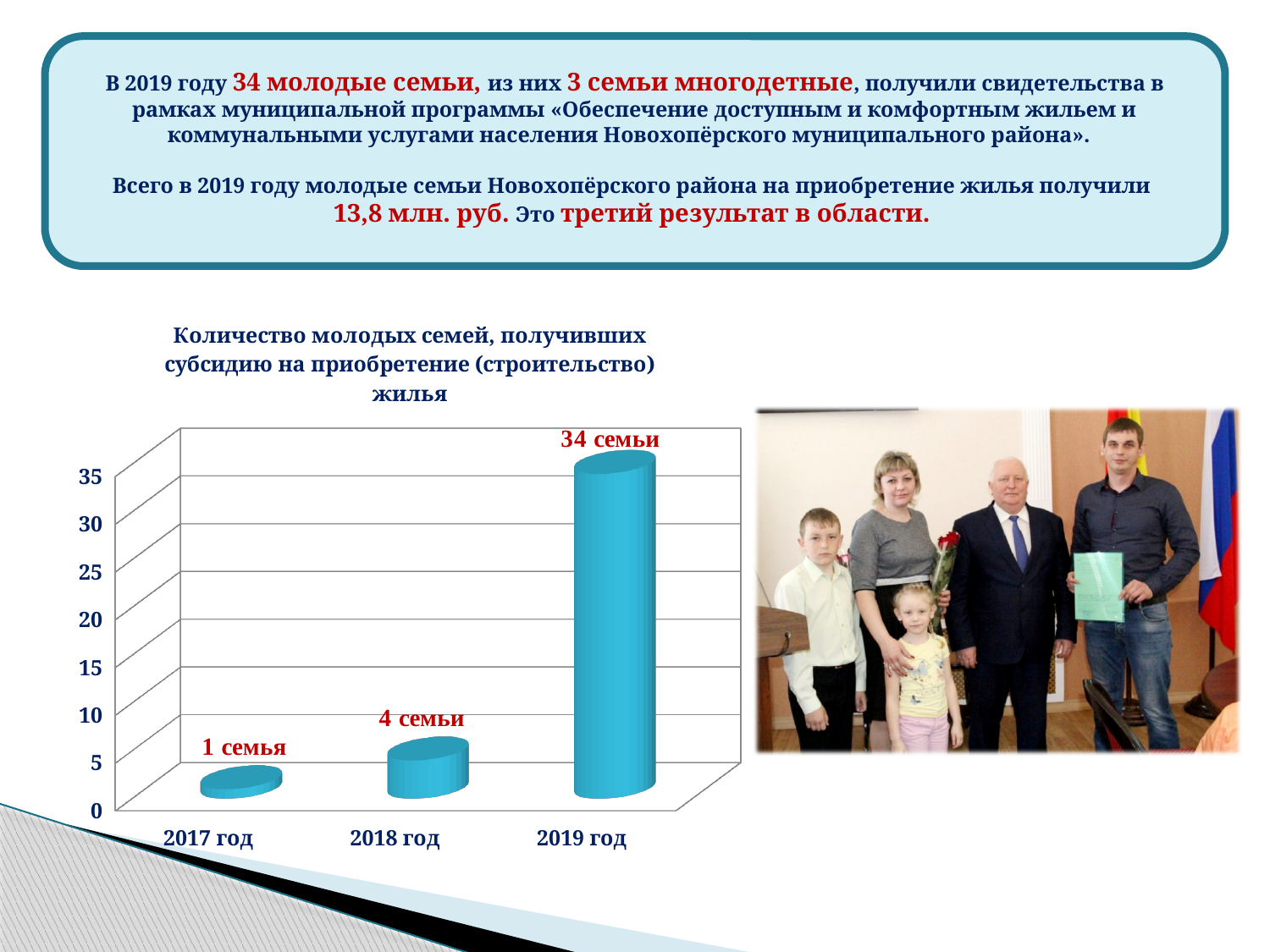
What kind of chart is shown on the slide? bar chart Which year has the lowest number of young families receiving a subsidy? 2017 год What is the difference between the values for 2019 год and 2018 год? 30 Is the value for 2019 год greater or less than 30? greater What is the difference between the values for 2018 год and 2017 год? 3 How many years are shown on the chart? 3 What is the value for 2019 год? 34 семьи What is the value for 2018 год? 4 семьи Do the values rise or fall from 2017 год to 2019 год? rise What is the value for 2017 год? 1 семья Which is larger, the value for 2018 год or the value for 2017 год? 2018 год Which year has the highest number of young families receiving a subsidy? 2019 год